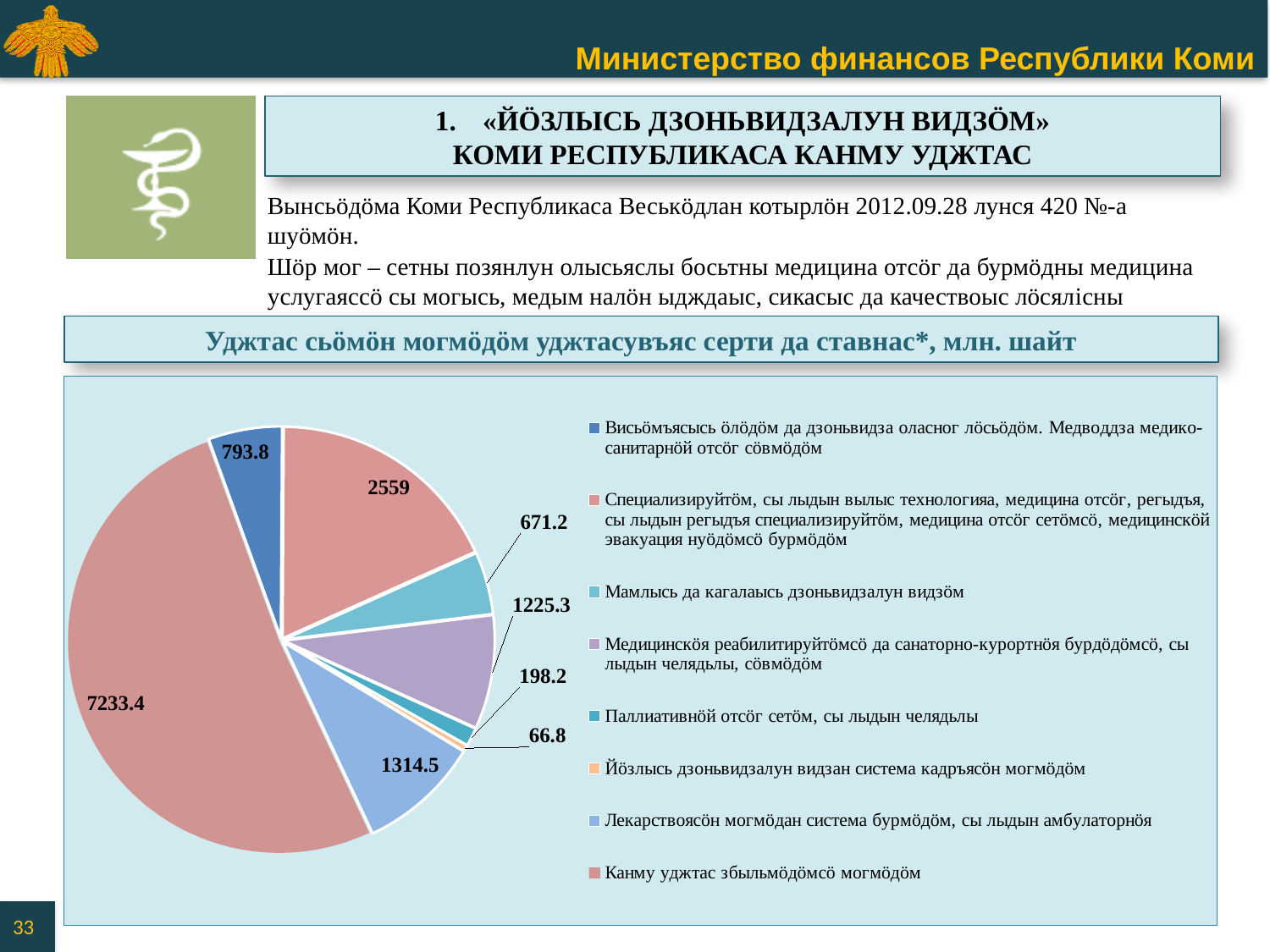
What is the difference between the slice labelled 2559 and the slice labelled 1314.5? 1244.5 What is the value of the slice for «Паллиативнöй отсöг сетöм, сы лыдын челядьлы»? 198.2 What unit is stated in the chart title? млн. шайт How many slices does the pie chart have? 8 Which slice of the pie chart has the smallest value? Йöзлысь дзоньвидзалун видзан система кадръясöн могмöдöм What kind of chart is shown on the slide? pie chart How many entries does the legend of the pie chart list? 8 What is the value of the slice for «Мамлысь да кагалаысь дзоньвидзалун видзöм»? 671.2 Which slice of the pie chart has the largest value? Канму уджтас збыльмöдöмсö могмöдöм Which is larger: the slice for «Медицинскöя реабилитируйтöмсö да санаторно-курортнöя бурдöдöмсö, сы лыдын челядьлы, сöвмöдöм» or the slice for «Висьöмъясысь öлöдöм да дзоньвидза оласног лöсьöдöм. Медводдза медико-санитарнöй отсöг сöвмöдöм»? Медицинскöя реабилитируйтöмсö да санаторно-курортнöя бурдöдöмсö, сы лыдын челядьлы, сöвмöдöм What is the value of the slice for «Канму уджтас збыльмöдöмсö могмöдöм»? 7233.4 What is the value of the slice for «Лекарствоясöн могмöдан система бурмöдöм, сы лыдын амбулаторнöя»? 1314.5